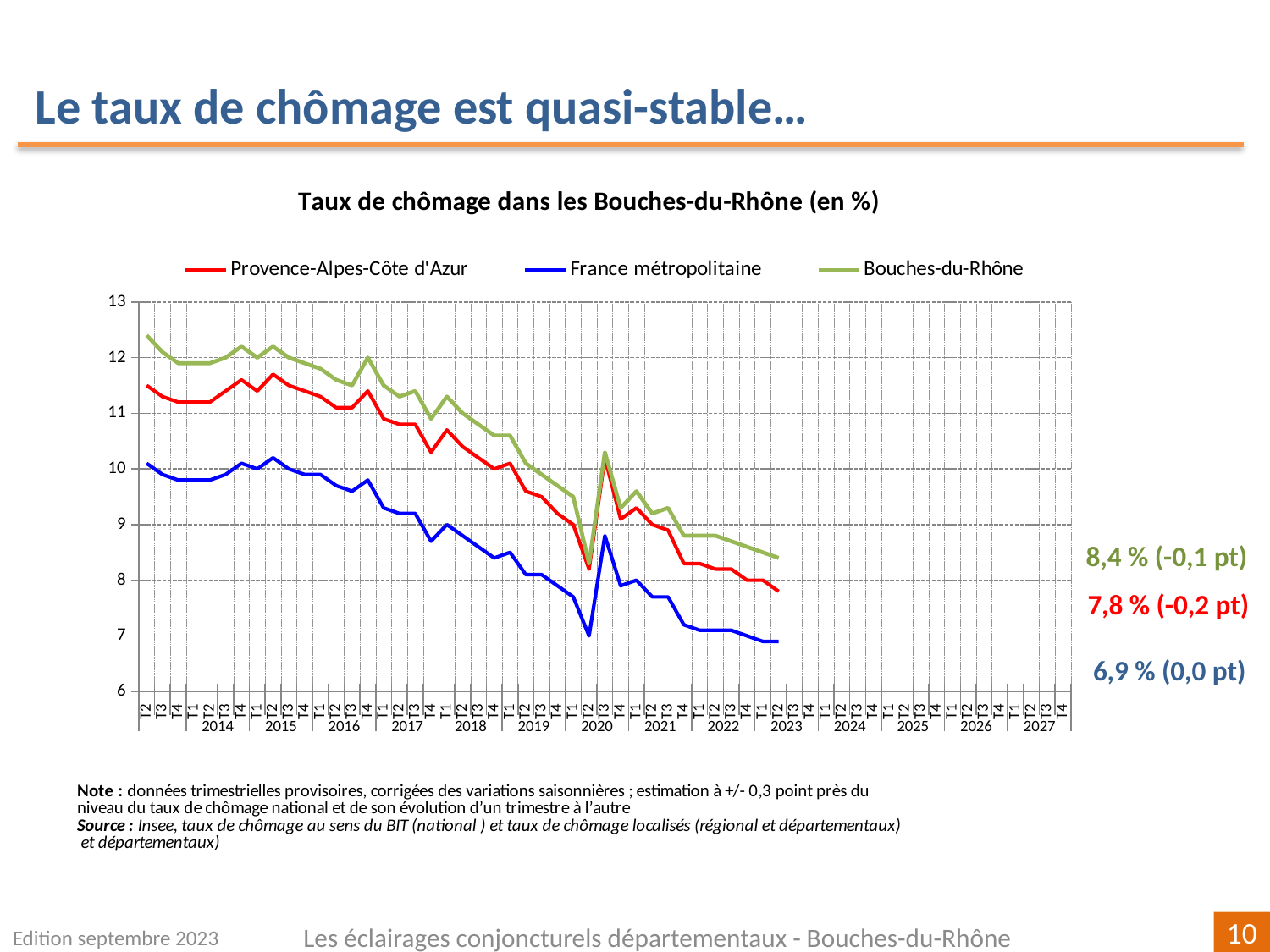
Which series has the lowest latest value? France métropolitaine Overall, do the unemployment rates rise or fall from 2013 to 2023? fall Which colour is used for the France métropolitaine line? blue What is the latest unemployment rate shown for France métropolitaine? 6,9 % Which series has the highest latest value? Bouches-du-Rhône What is the difference between the latest Bouches-du-Rhône rate and the latest France métropolitaine rate? 1,5 points What kind of chart is shown on the slide? line chart What is the latest unemployment rate shown for Provence-Alpes-Côte d'Azur? 7,8 % What is the latest unemployment rate shown for Bouches-du-Rhône? 8,4 % What is the quarterly change shown next to the latest Provence-Alpes-Côte d'Azur value? -0,2 pt What is the title of the chart? Taux de chômage dans les Bouches-du-Rhône (en %) How many series does the legend list? 3